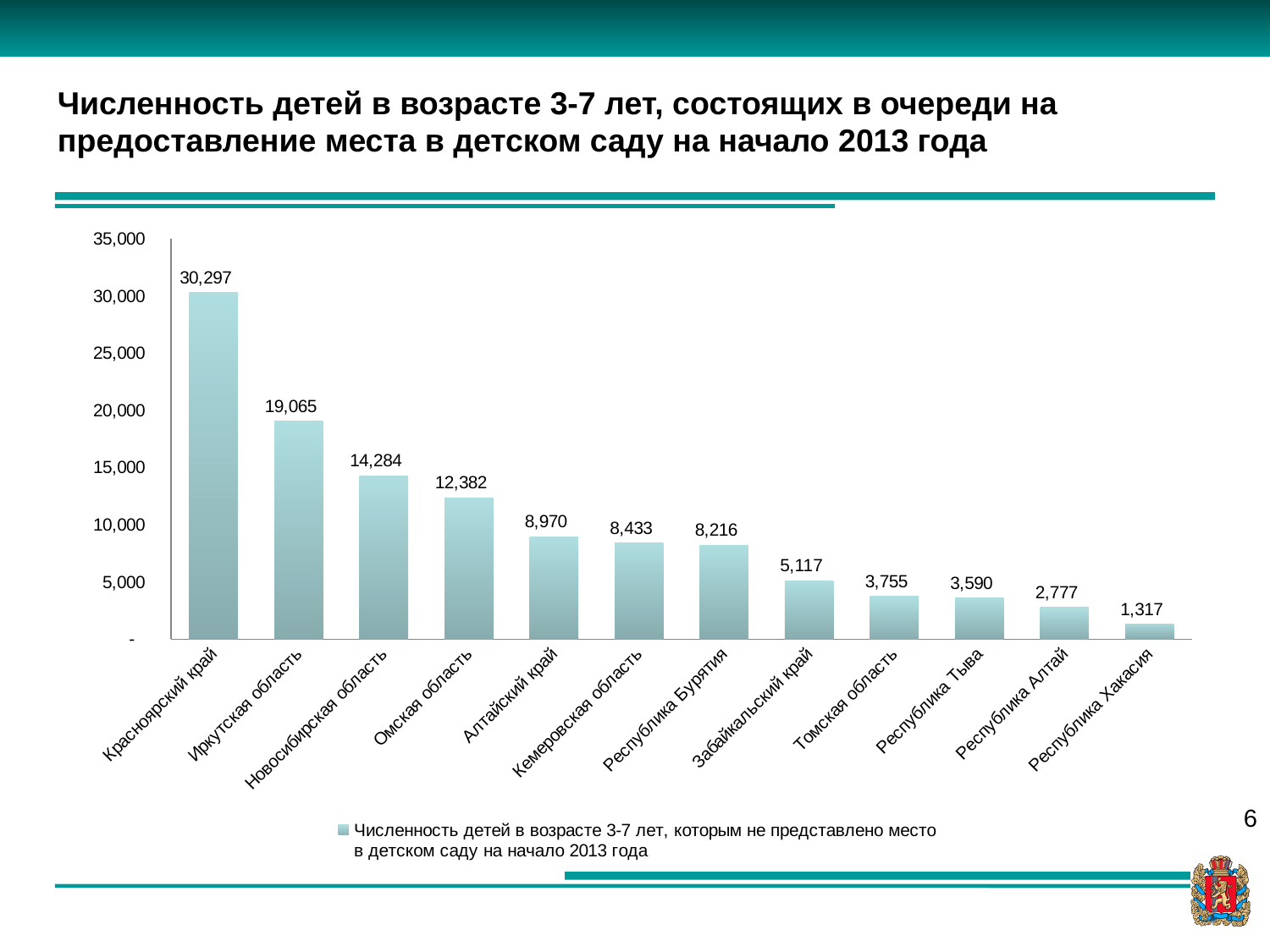
What is the value for Красноярский край? 30,297 Is the value for Кемеровская область greater or less than 10,000? less What is the value for Омская область? 12,382 Which region has the highest value? Красноярский край Do the values rise or fall from left to right along the x axis? fall Which region has the lowest value? Республика Хакасия How many series does the legend list? 1 What kind of chart is shown on the slide? bar chart What is the value for Республика Тыва? 3,590 Which is larger, the value for Алтайский край or the value for Забайкальский край? Алтайский край What is the difference between the values for Иркутская область and Новосибирская область? 4,781 How many regions are shown on the chart? 12